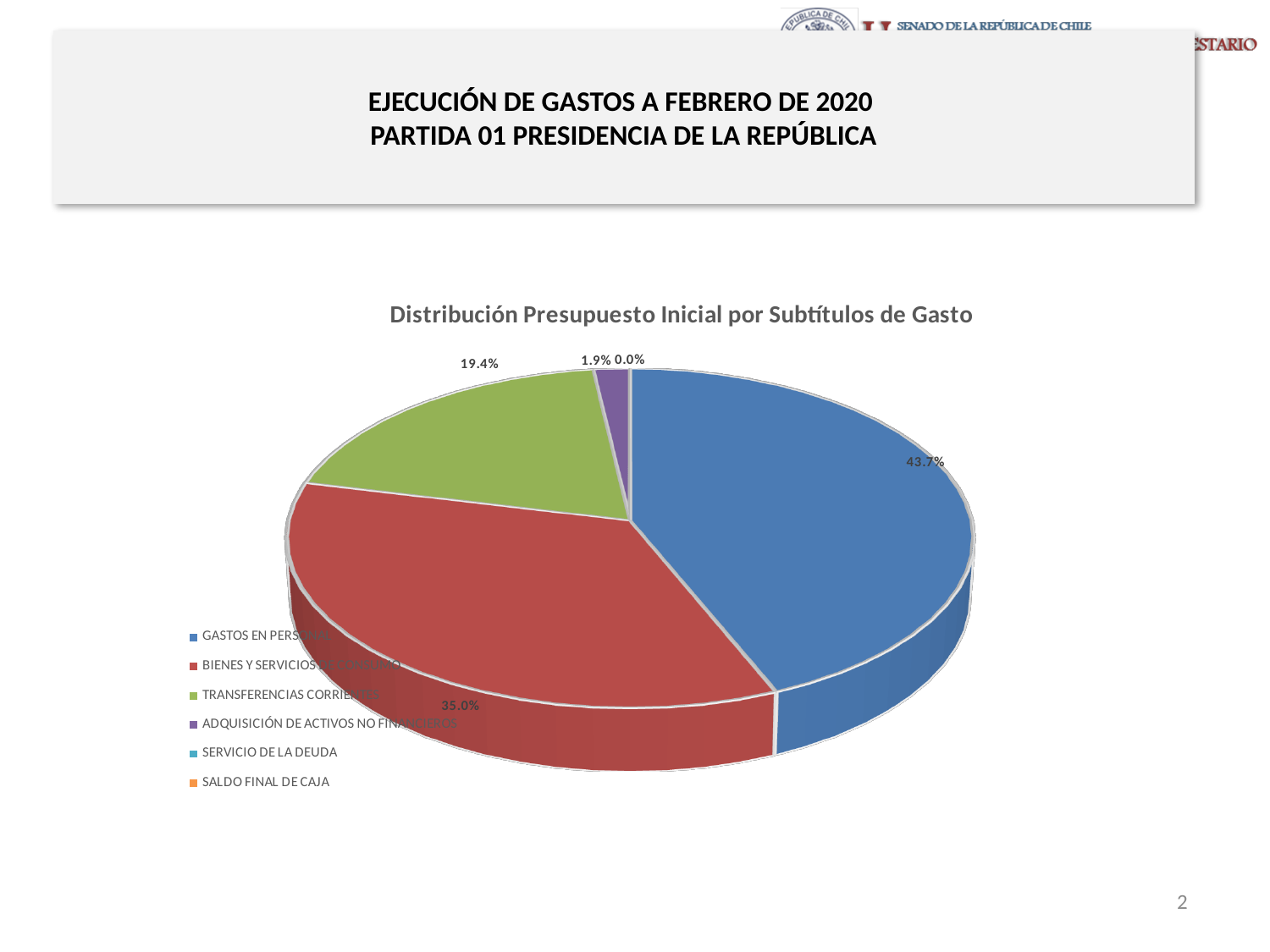
Which category has the largest share of the pie? GASTOS EN PERSONAL What kind of chart is shown on the slide? Pie chart What share of the pie does BIENES Y SERVICIOS DE CONSUMO represent? 35.0% What colour is the slice for GASTOS EN PERSONAL? Blue What share of the pie does TRANSFERENCIAS CORRIENTES represent? 19.4% Which is larger, the share for TRANSFERENCIAS CORRIENTES or the share for ADQUISICIÓN DE ACTIVOS NO FINANCIEROS? TRANSFERENCIAS CORRIENTES What is the difference in percentage points between GASTOS EN PERSONAL and BIENES Y SERVICIOS DE CONSUMO? 8.7 What share of the pie does GASTOS EN PERSONAL represent? 43.7% What is the title of the chart? Distribución Presupuesto Inicial por Subtítulos de Gasto How many categories does the legend list? 6 What is the difference in percentage points between BIENES Y SERVICIOS DE CONSUMO and TRANSFERENCIAS CORRIENTES? 15.6